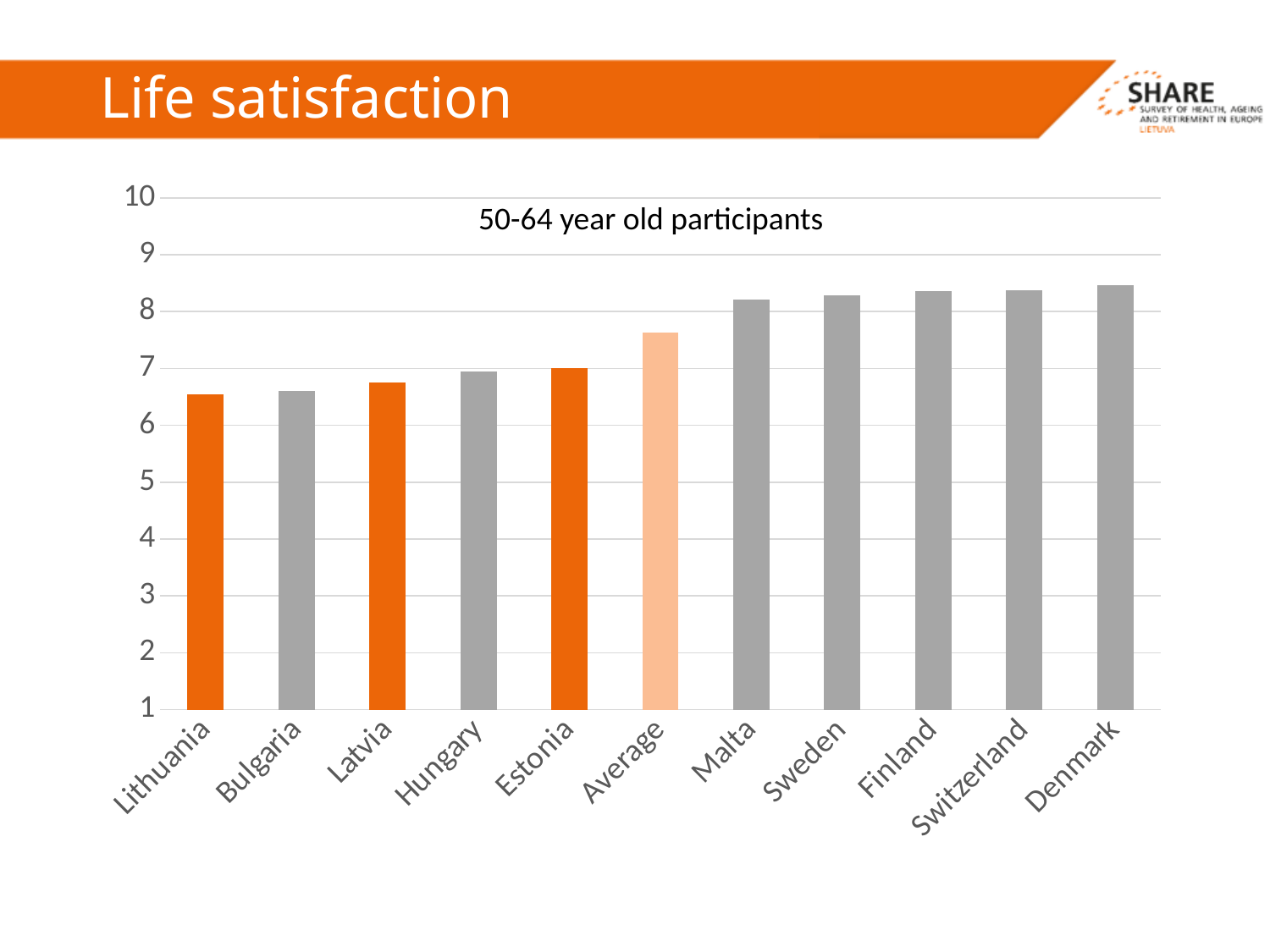
Is the value for Lithuania greater or less than 7? less Which is larger, the value for Lithuania or the value for Estonia? Estonia Which is larger, the value for Sweden or the value for Hungary? Sweden Is the value for Latvia greater or less than 7? less Do the values generally rise or fall from left to right along the x axis? rise Is the value for Denmark greater or less than 8? greater What kind of chart is shown on the slide? bar chart How many categories are plotted on the x axis of the chart? 11 Which category has the highest life satisfaction value in the chart? Denmark What is the title shown inside the chart area? 50-64 year old participants